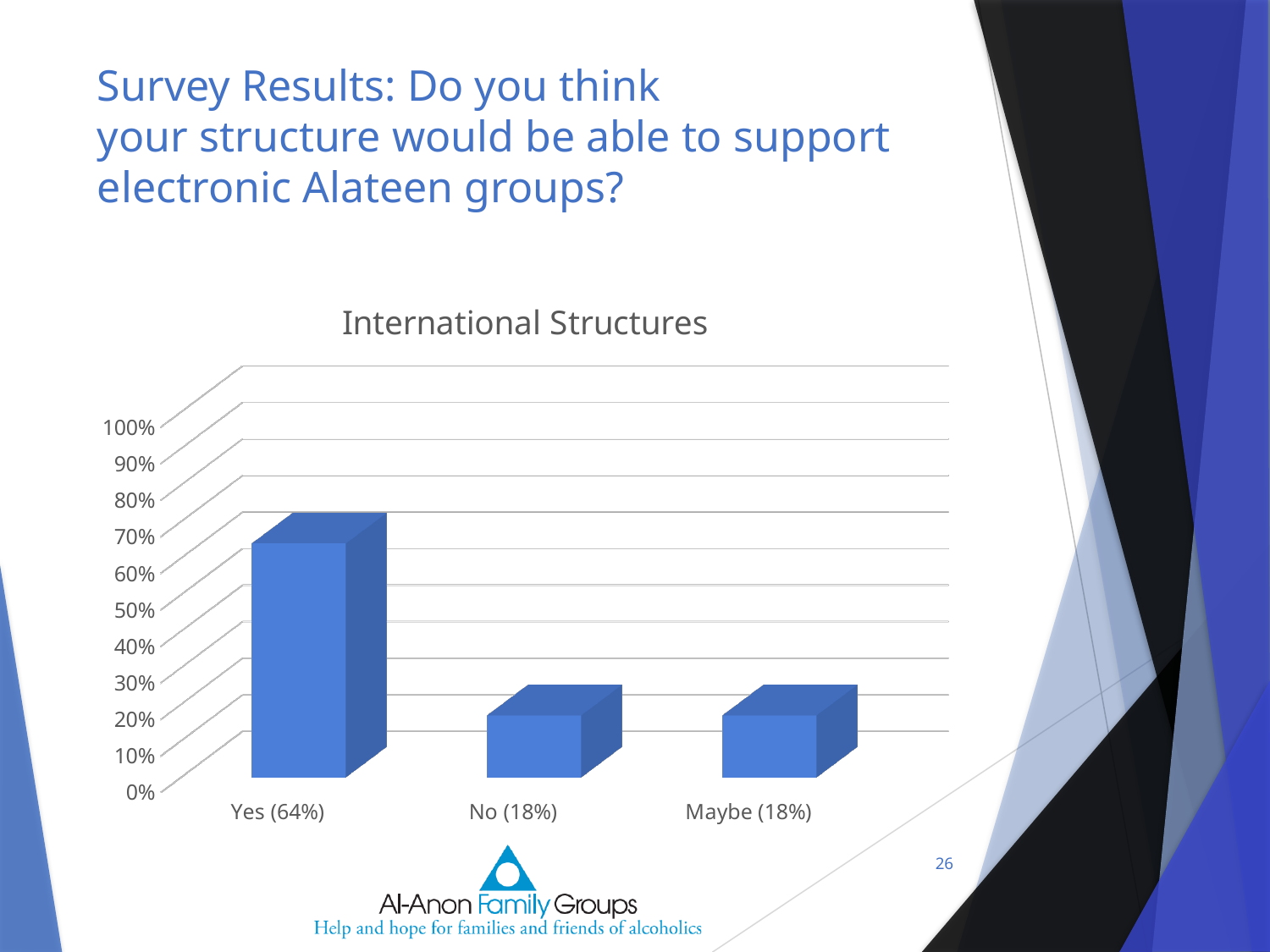
How many categories are shown in the chart? 3 Is the value for No greater or less than 30%? less What type of chart is shown on the slide? bar chart Which is larger, the value for Yes or the value for Maybe? Yes What percentage of respondents answered Yes? 64% What percentage of respondents answered No? 18% Which category has the highest value? Yes What is the difference between the Yes and No percentages? 46% What is the title of the chart? International Structures Is the value for Yes greater or less than 50%? greater What is the highest value shown on the vertical axis? 100% What percentage of respondents answered Maybe? 18%